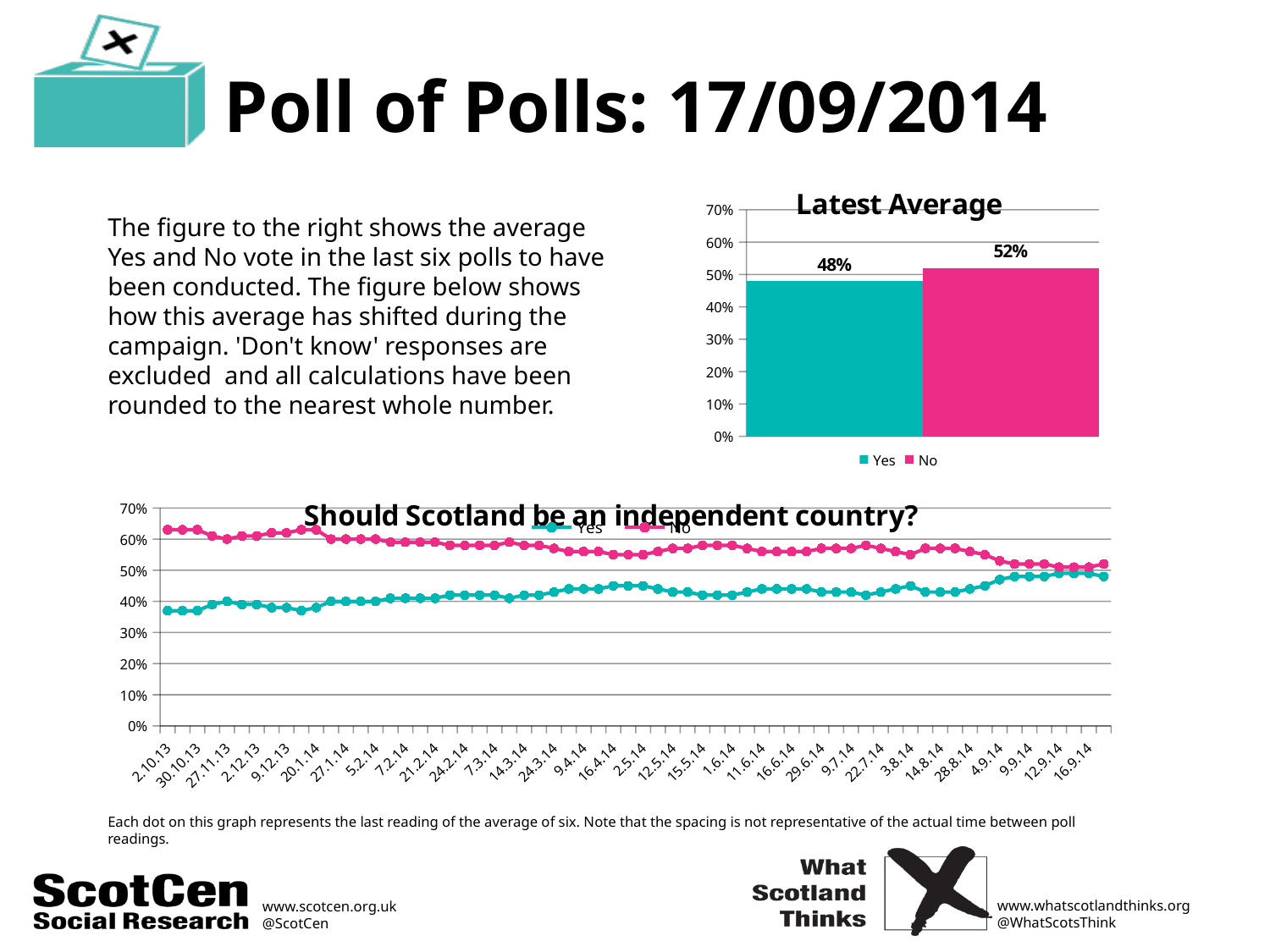
How many series does the legend of the "Latest Average" chart list? 2 In the "Should Scotland be an independent country?" chart, is the No value at 2.10.13 greater or less than 60%? greater In the "Latest Average" chart, what is the value for No? 52% In the "Should Scotland be an independent country?" chart, does the No line generally rise or fall from left to right? Fall In the "Latest Average" chart, what is the difference between the No and Yes values? 4% In the "Should Scotland be an independent country?" chart, which series is shown in pink? No In the "Latest Average" chart, which category has the higher value? No In the "Latest Average" chart, what is the total of the Yes and No values? 100% In the "Latest Average" chart, what is the value for Yes? 48% In the "Should Scotland be an independent country?" chart, does the Yes line generally rise or fall from left to right? Rise What kind of chart is "Should Scotland be an independent country?"? Line chart What kind of chart is the "Latest Average" chart? Bar chart